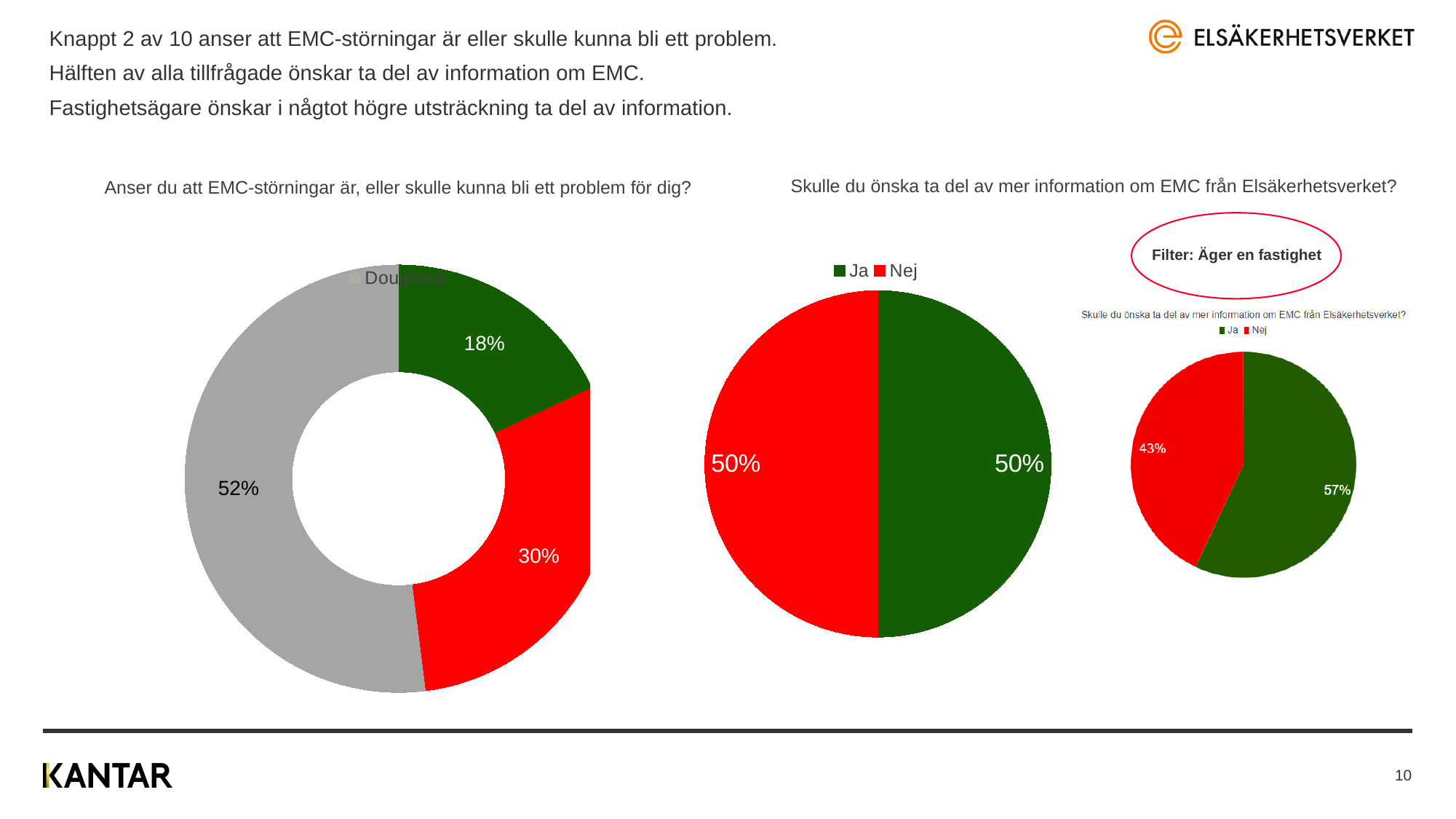
In the left doughnut chart, how many slices are there? 3 How many series does the legend of the middle pie chart list? 2 In the left doughnut chart 'Anser du att EMC-störningar är, eller skulle kunna bli ett problem för dig?', what value is shown on the grey slice? 52% In the small right-hand pie chart with the filter 'Äger en fastighet', which answer has the larger share, 'Ja' or 'Nej'? Ja In the middle pie chart, what share of respondents answered 'Ja'? 50% What kind of chart is the middle chart 'Skulle du önska ta del av mer information om EMC från Elsäkerhetsverket?'? pie chart In the left doughnut chart, what is the difference between the grey slice and the red slice? 22% In the middle pie chart, what share of respondents answered 'Nej'? 50% In the left doughnut chart, what value is shown on the red slice? 30% In the left doughnut chart, what value is shown on the green slice? 18% In the small right-hand pie chart with the filter 'Äger en fastighet', what is the difference between the 'Ja' and 'Nej' shares? 14% In the small right-hand pie chart with the filter 'Äger en fastighet', what share answered 'Ja'? 57%